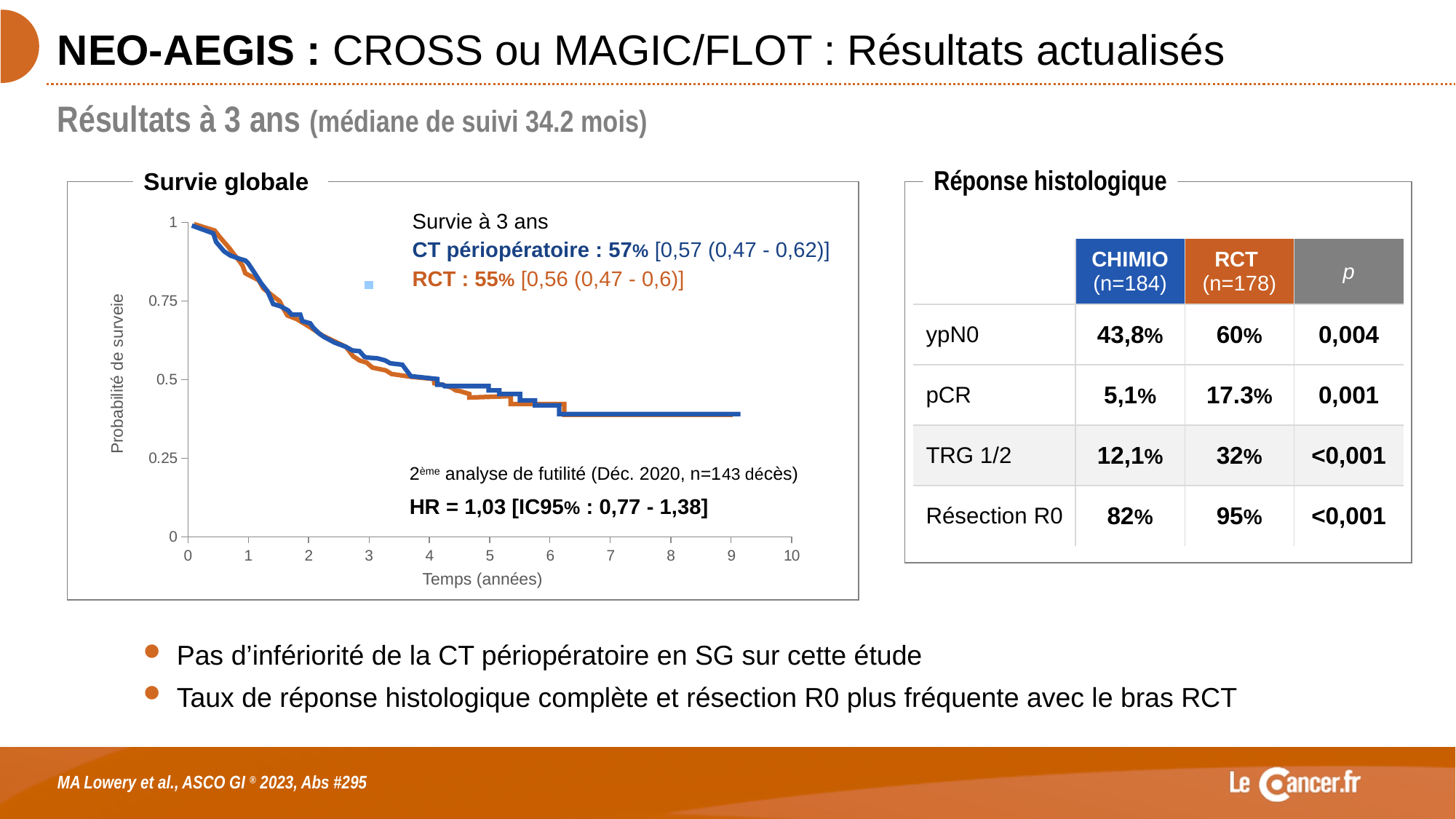
In the 'Survie globale' chart, what is the 95% confidence interval of the hazard ratio? 0,77 - 1,38 In the 'Survie globale' chart, is the survival probability of the blue curve at 6 years greater or less than 0.5? less In the 'Survie globale' chart, is the survival probability of the blue curve at 1 year greater or less than 0.75? greater In the 'Survie globale' chart, do the survival curves rise or fall as time increases? fall In the 'Survie globale' chart, what is the difference in 3-year survival between the CT périopératoire arm (57%) and the RCT arm (55%)? 2% In the 'Survie globale' chart, how many treatment arms (series) are plotted? 2 In the 'Survie globale' chart, which arm has the higher 3-year survival rate, CT périopératoire or RCT? CT périopératoire In the 'Survie globale' chart, what is the 3-year survival rate for the RCT arm? 55% In the 'Survie globale' chart, what hazard ratio (HR) is reported? 1,03 In the 'Survie globale' chart, what is the 3-year survival rate for the CT périopératoire arm? 57% In the 'Survie globale' chart, what is the label of the x axis? Temps (années) What kind of chart is shown under the heading 'Survie globale'? line chart